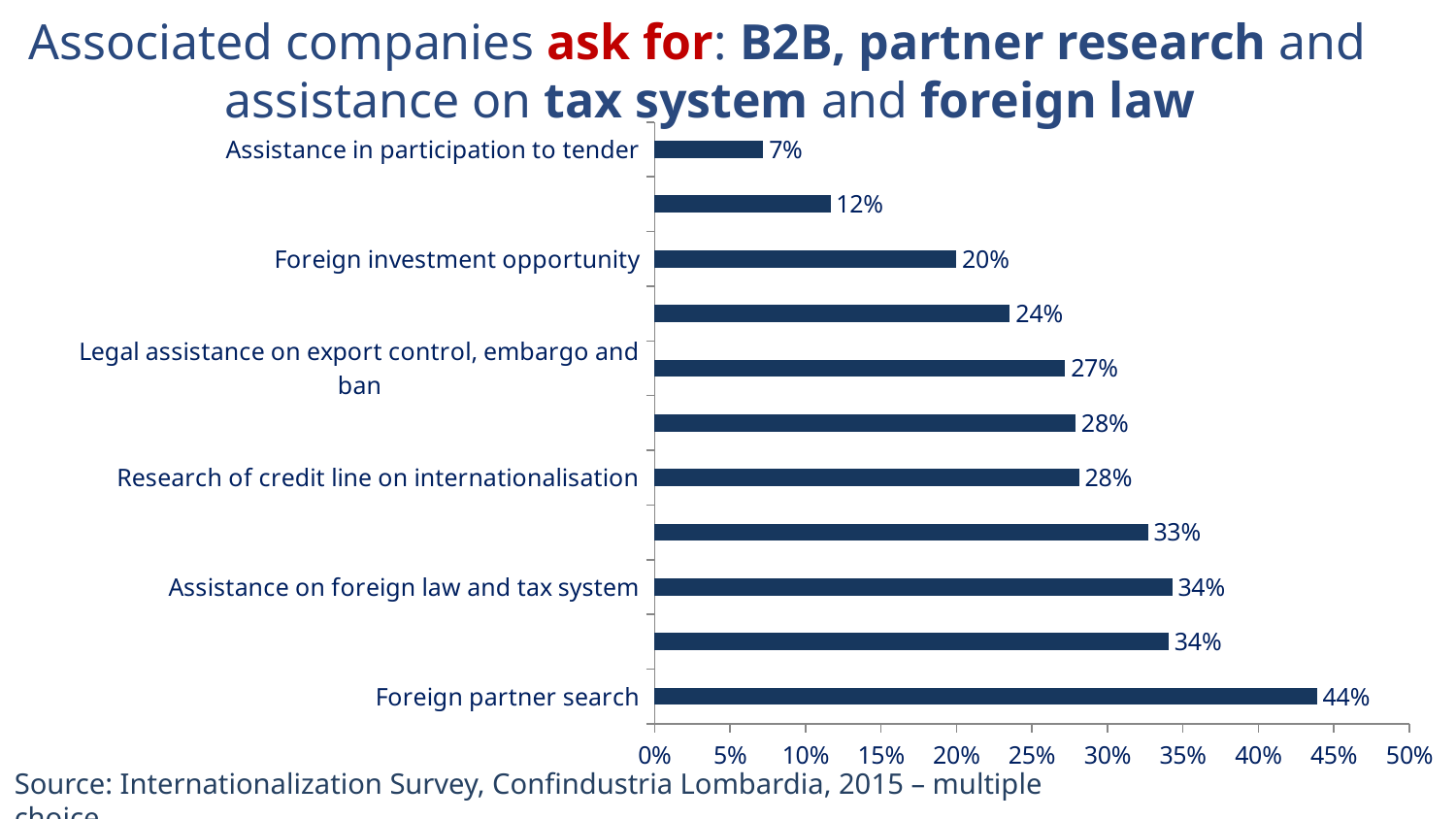
What is the value for Legal assistance on export control, embargo and ban? 27% What is the value for Research of credit line on internationalisation? 28% What kind of chart is shown on the slide? Bar chart Which category has the highest value? Foreign partner search How many bars are plotted in the chart? 11 Which is larger, the value for Foreign investment opportunity or the value for Research of credit line on internationalisation? Research of credit line on internationalisation What is the value for Foreign partner search? 44% What is the value for Assistance in participation to tender? 7% What is the difference between the values for Foreign partner search and Assistance on foreign law and tax system? 10% Which category has the lowest value? Assistance in participation to tender What is the value for Assistance on foreign law and tax system? 34% What is the value for Foreign investment opportunity? 20%